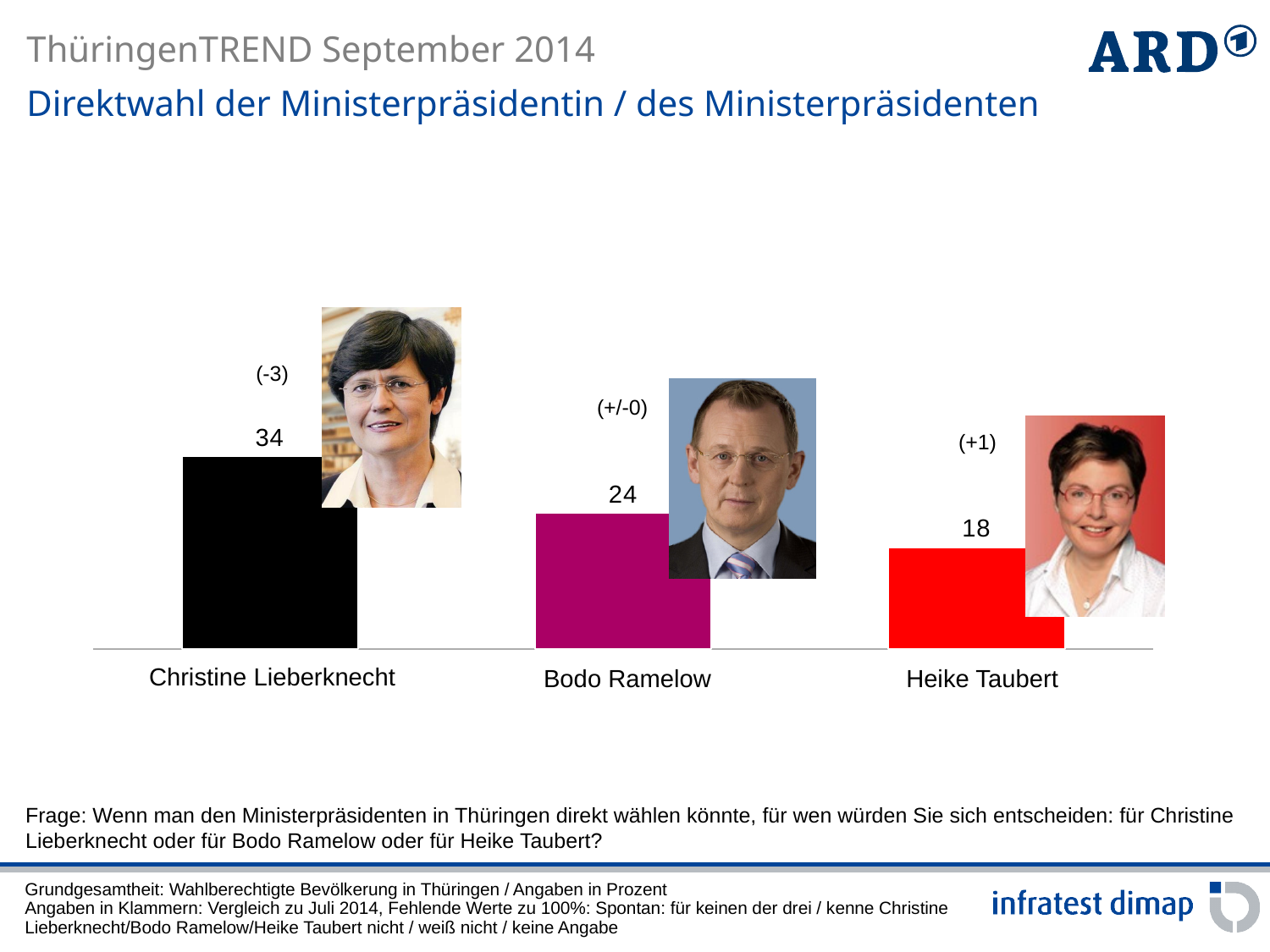
What kind of chart is shown on the slide? Bar chart What value is shown for Bodo Ramelow? 24 What value is shown for Christine Lieberknecht? 34 What is the difference between the values for Christine Lieberknecht and Bodo Ramelow? 10 What value is shown for Heike Taubert? 18 What change compared to July 2014 is shown in parentheses for Christine Lieberknecht? (-3) What change compared to July 2014 is shown in parentheses for Heike Taubert? (+1) How many candidates are shown in the chart? 3 Which candidate has the lowest value? Heike Taubert Who has the larger value, Bodo Ramelow or Heike Taubert? Bodo Ramelow What is the difference between the values for Bodo Ramelow and Heike Taubert? 6 Which candidate has the highest value? Christine Lieberknecht